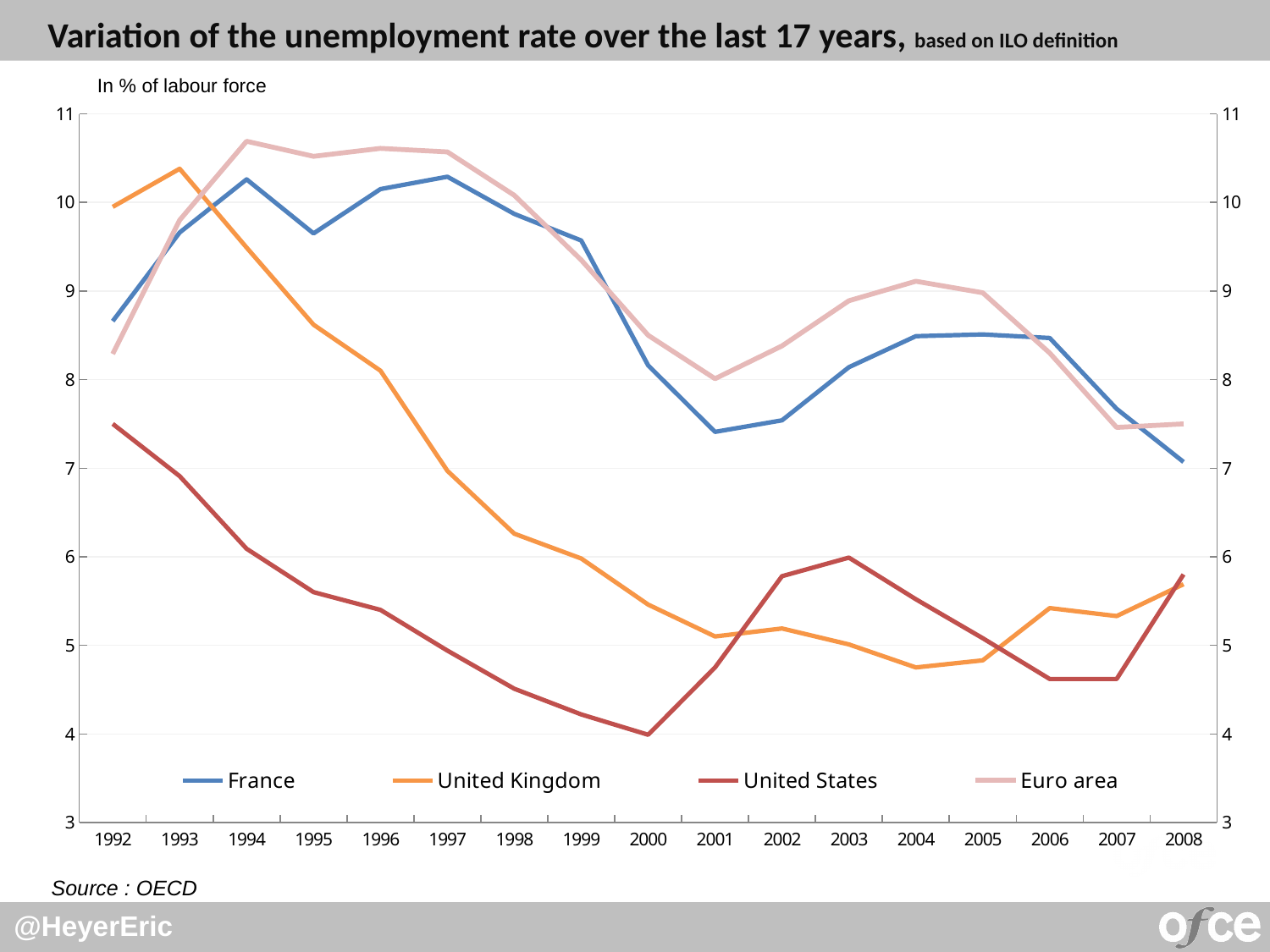
What kind of chart is shown on the slide? line chart How many series does the legend list? 4 Is the value for the United Kingdom in 1993 greater or less than 10? greater Is the value for the United Kingdom in 2004 greater or less than 5? less In 2000, which is larger: the value for France or the value for the United Kingdom? France How many years are shown along the x axis? 17 Which series has the highest unemployment rate in 1992? United Kingdom Is the value for France in 2001 greater or less than 8? less What is the source cited below the chart? OECD Which series has the lowest unemployment rate in 1992? United States Which series has the highest unemployment rate in 2008? Euro area Does the United Kingdom line rise or fall between 1993 and 2001? fall